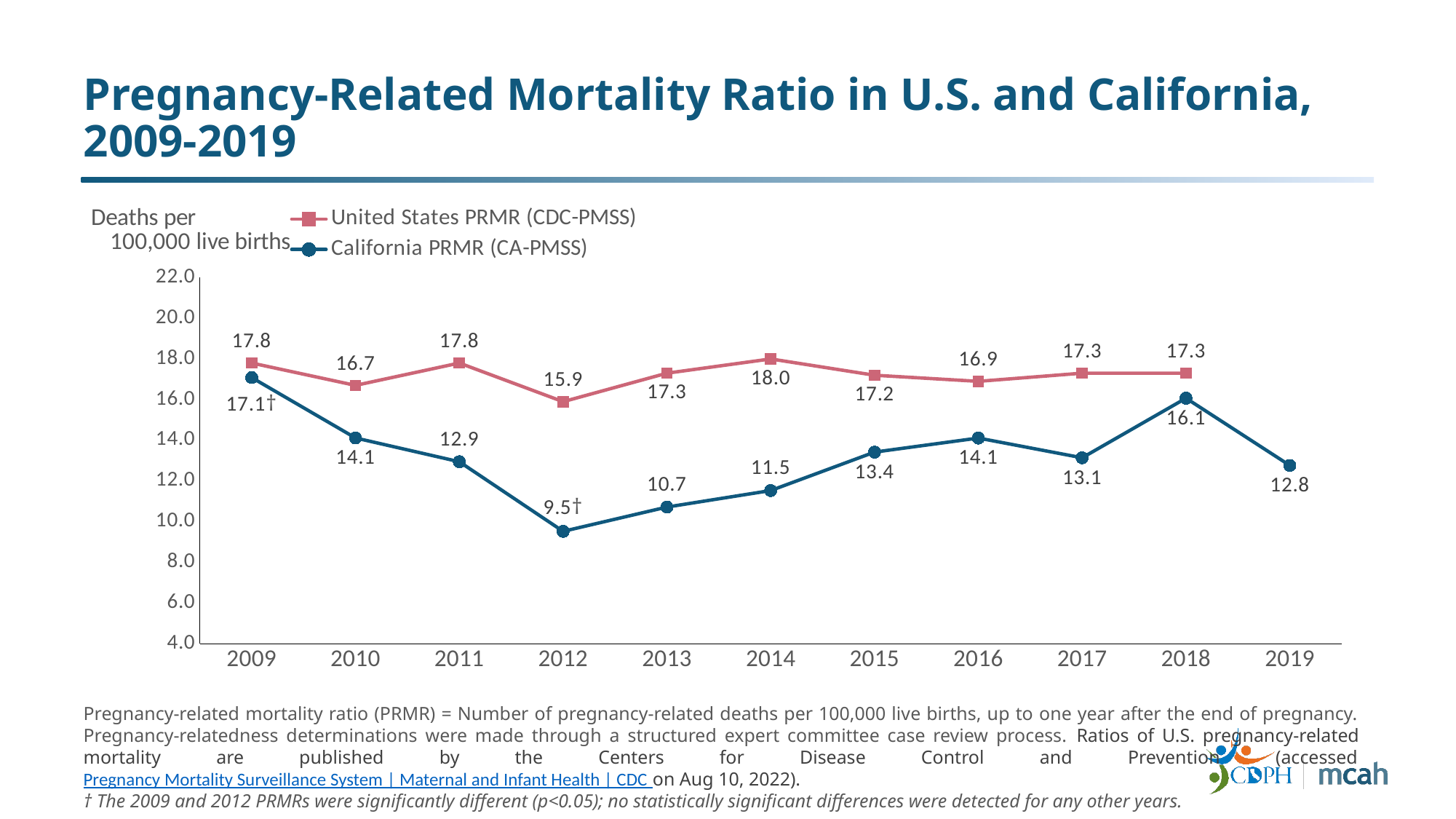
What is the difference between the United States PRMR and the California PRMR in 2012? 6.4 What is the California PRMR (CA-PMSS) value for 2012? 9.5 How many series does the legend list? 2 In which year is the California PRMR (CA-PMSS) lowest? 2012 Does the California PRMR (CA-PMSS) rise or fall from 2018 to 2019? Fall What is the California PRMR (CA-PMSS) value for 2019? 12.8 What kind of chart is shown on the slide? Line chart In which year is the United States PRMR (CDC-PMSS) highest? 2014 Which series has the larger value in 2018, United States PRMR (CDC-PMSS) or California PRMR (CA-PMSS)? United States PRMR (CDC-PMSS) What is the United States PRMR (CDC-PMSS) value for 2014? 18.0 What unit is given for the y axis of the chart? Deaths per 100,000 live births How many years are shown on the x axis? 11